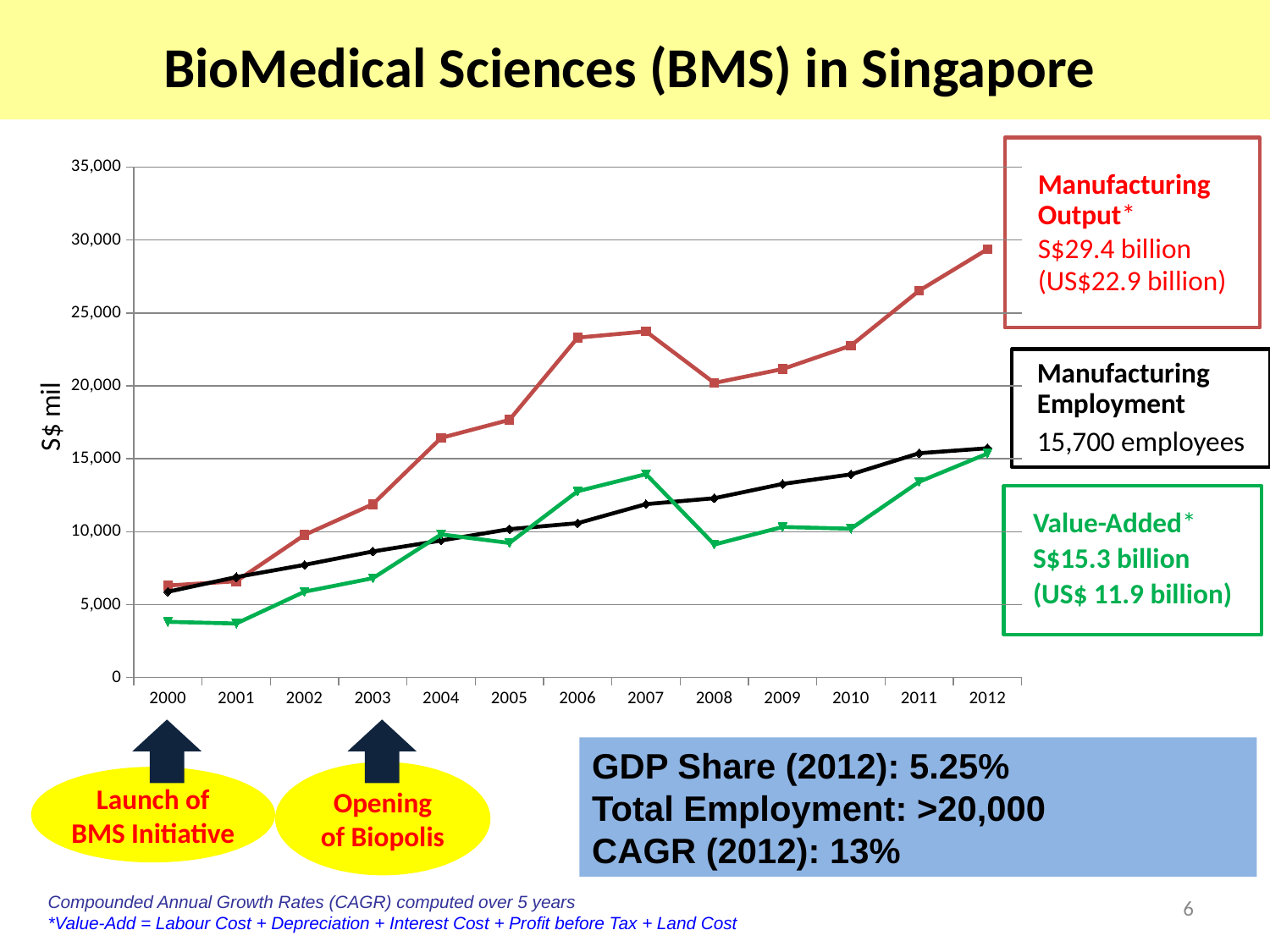
Which series has the highest value in 2012? Manufacturing Output What is the label on the vertical axis of the chart? S$ mil How many data series are plotted on the chart? 3 According to the annotation on the chart, what is the Manufacturing Employment figure for 2012? 15,700 employees Is the Manufacturing Output value for 2012 greater or less than 25,000? greater How many years are plotted along the x axis of the chart? 13 Is the Manufacturing Output value for 2006 greater or less than 20,000? greater What kind of chart is shown on the slide? line chart Is the Value-Added value for 2008 greater or less than 10,000? less Does Manufacturing Employment rise or fall from 2000 to 2012? rise In 2007, which is larger: Manufacturing Output or Value-Added? Manufacturing Output